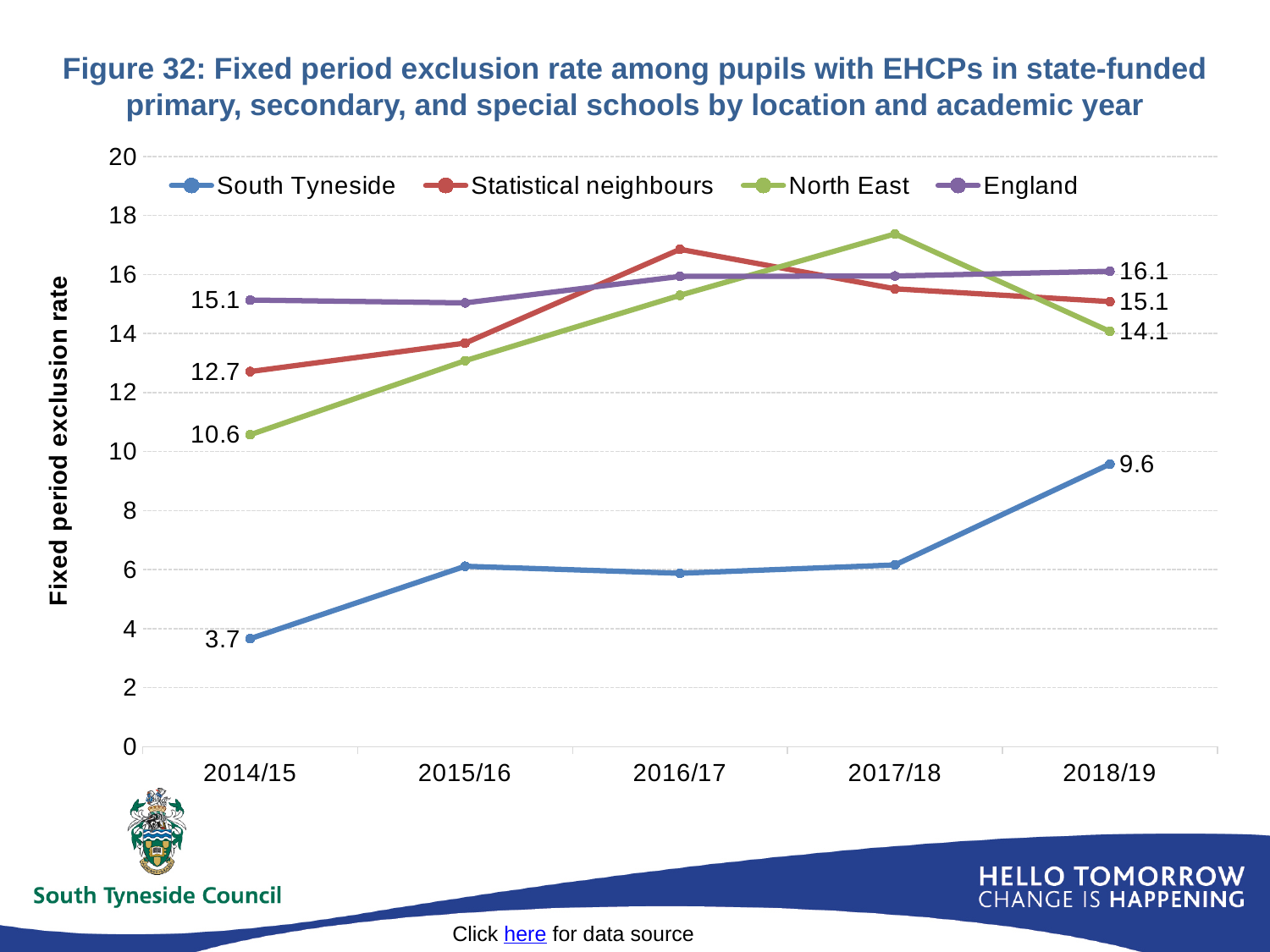
Did the South Tyneside fixed period exclusion rate rise or fall between 2014/15 and 2018/19? Rise Which series had the highest fixed period exclusion rate in 2014/15? England What was the fixed period exclusion rate for North East in 2014/15? 10.6 What type of chart is shown on the slide? Line chart What was the fixed period exclusion rate for South Tyneside in 2014/15? 3.7 What was the fixed period exclusion rate for Statistical neighbours in 2018/19? 15.1 Is the value for South Tyneside in 2017/18 greater or less than 8? less What was the fixed period exclusion rate for England in 2018/19? 16.1 How many series does the legend list? 4 By how much did the South Tyneside fixed period exclusion rate increase from 2014/15 to 2018/19? 5.9 How many academic years are shown on the x axis? 5 Which series had the lowest fixed period exclusion rate in 2018/19? South Tyneside